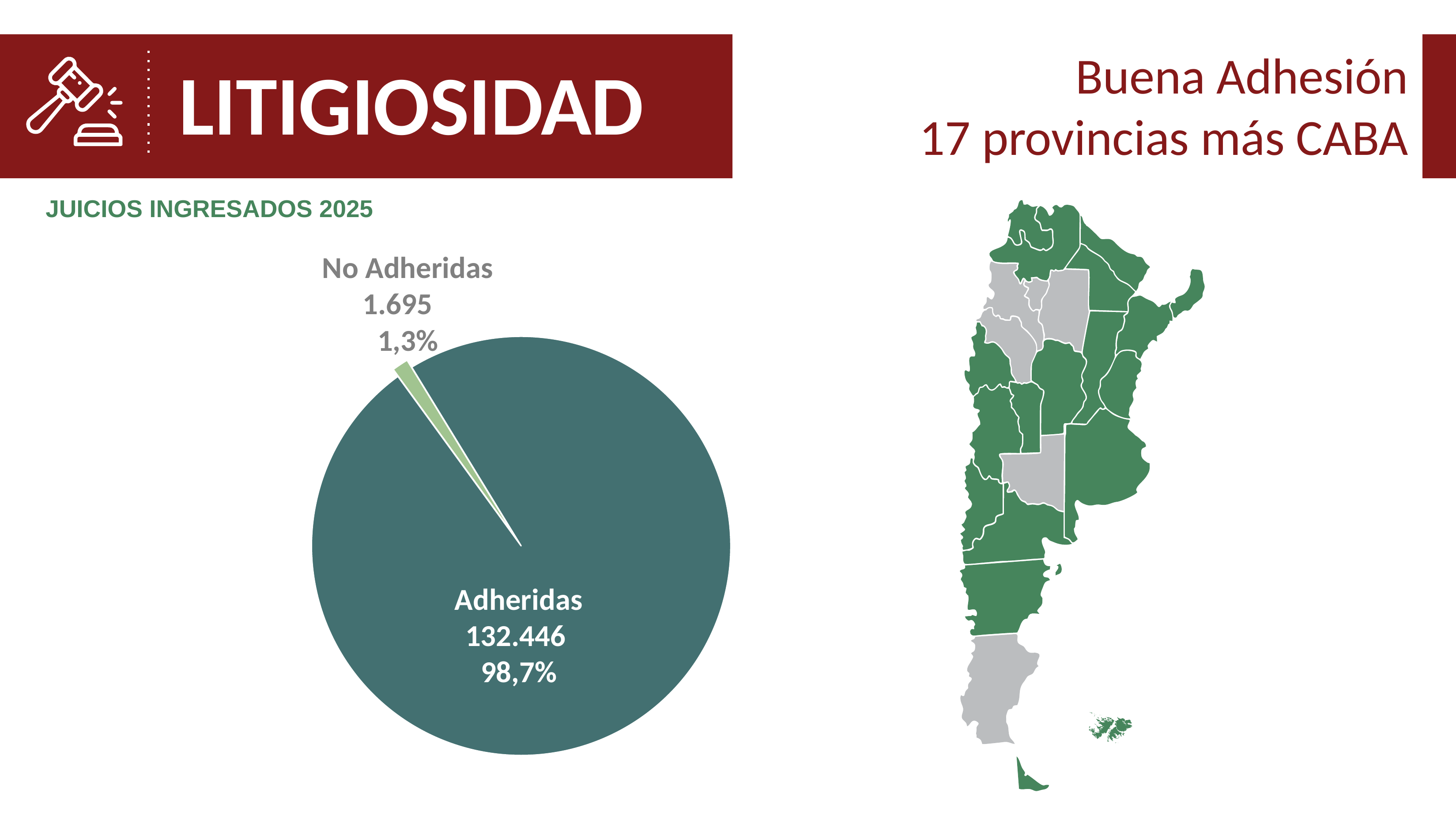
In the JUICIOS INGRESADOS 2025 pie chart, which is larger, Adheridas or No Adheridas? Adheridas In the JUICIOS INGRESADOS 2025 pie chart, what is the value for No Adheridas? 1.695 In the JUICIOS INGRESADOS 2025 pie chart, which slice is the smallest? No Adheridas How many slices does the JUICIOS INGRESADOS 2025 pie chart have? 2 In the JUICIOS INGRESADOS 2025 pie chart, what is the difference between the Adheridas and No Adheridas values? 130.751 In the JUICIOS INGRESADOS 2025 pie chart, what is the value for Adheridas? 132.446 In the JUICIOS INGRESADOS 2025 pie chart, what is the total of the two slices? 134.141 In the JUICIOS INGRESADOS 2025 pie chart, which slice is the largest? Adheridas What kind of chart is shown under the heading JUICIOS INGRESADOS 2025? Pie chart In the JUICIOS INGRESADOS 2025 pie chart, what share of the pie does No Adheridas represent? 1,3% In the JUICIOS INGRESADOS 2025 pie chart, what share of the pie does Adheridas represent? 98,7% What is the title of the pie chart on the slide? JUICIOS INGRESADOS 2025